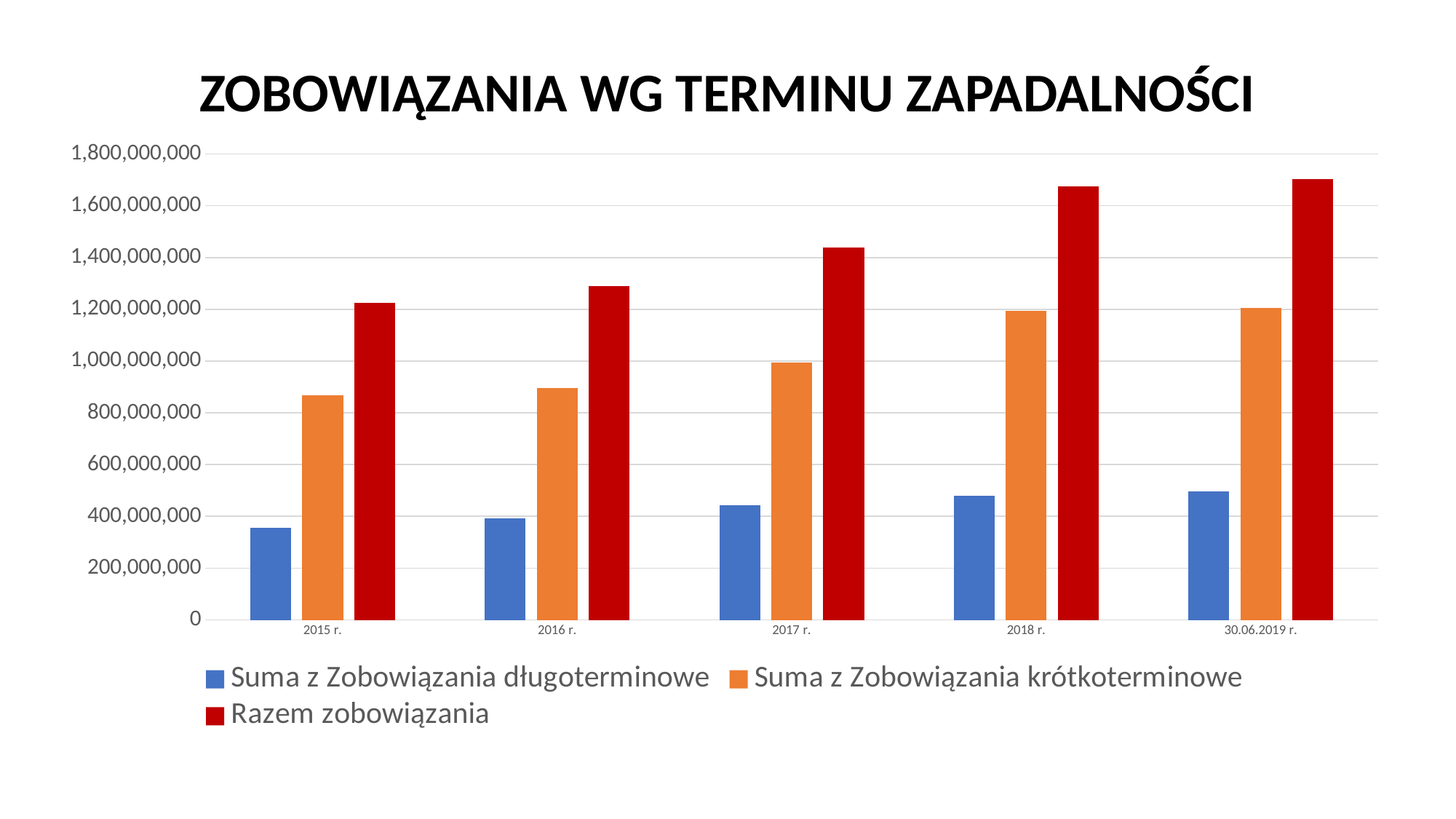
What kind of chart is shown on the slide? bar chart Is the value for Suma z Zobowiązania krótkoterminowe in 2015 r. greater or less than 800,000,000? greater How many series does the legend list? 3 What is the title of the chart? ZOBOWIĄZANIA WG TERMINU ZAPADALNOŚCI Is the value for Razem zobowiązania in 2018 r. greater or less than 1,600,000,000? greater How many categories are shown on the x axis? 5 Do the values for Razem zobowiązania rise or fall from 2015 r. to 30.06.2019 r.? rise In which category is Suma z Zobowiązania długoterminowe lowest? 2015 r. Is the value for Suma z Zobowiązania długoterminowe in 2015 r. greater or less than 400,000,000? less Which series is shown in red? Razem zobowiązania Which is larger: Razem zobowiązania in 2016 r. or in 2017 r.? 2017 r.